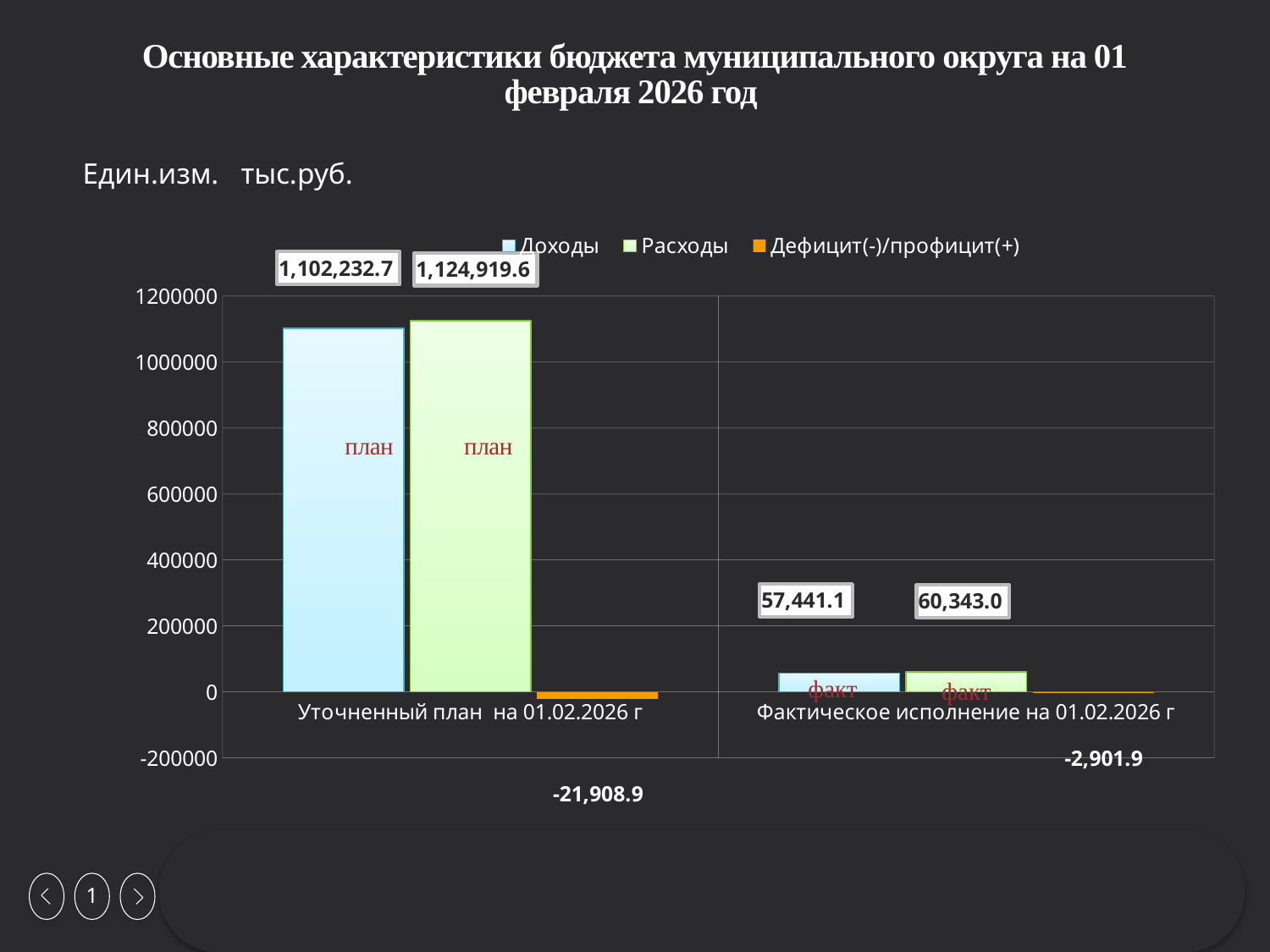
What is the value of Расходы for Уточненный план на 01.02.2026 г? 1,124,919.6 What is the difference between Расходы and Доходы for Фактическое исполнение на 01.02.2026 г? 2,901.9 What is the value of Дефицит(-)/профицит(+) for Уточненный план на 01.02.2026 г? -21,908.9 What kind of chart is shown on the slide? bar chart What is the value of Дефицит(-)/профицит(+) for Фактическое исполнение на 01.02.2026 г? -2,901.9 How many series does the legend list? 3 Which is larger for Фактическое исполнение на 01.02.2026 г: Доходы or Расходы? Расходы Which series has the highest value for Уточненный план на 01.02.2026 г? Расходы What is the value of Расходы for Фактическое исполнение на 01.02.2026 г? 60,343.0 What is the value of Доходы for Фактическое исполнение на 01.02.2026 г? 57,441.1 What is the value of Доходы for Уточненный план на 01.02.2026 г? 1,102,232.7 How many categories are shown on the x axis? 2